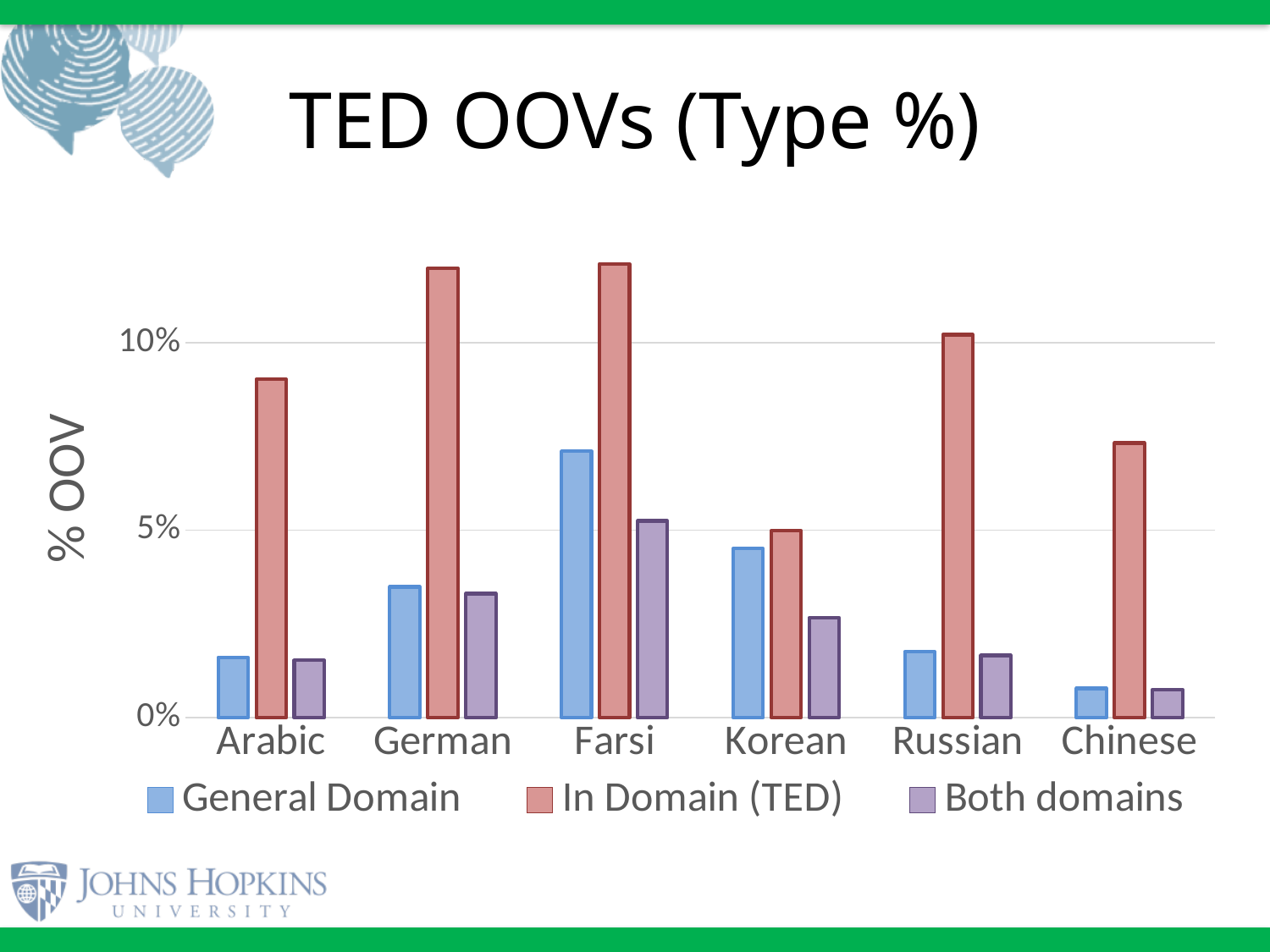
Which language has the highest Both domains value? Farsi Which is larger, the In Domain (TED) value for Arabic or for Chinese? Arabic Is the General Domain value for Farsi greater or less than 5%? greater How many series does the legend list? 3 Which language has the lowest General Domain value? Chinese Is the Both domains value for Korean greater or less than 5%? less Is the In Domain (TED) value for Korean greater or less than 10%? less Which language has the highest General Domain value? Farsi How many languages are shown on the x axis? 6 What kind of chart is shown on the slide? bar chart What is the title of the chart? TED OOVs (Type %)